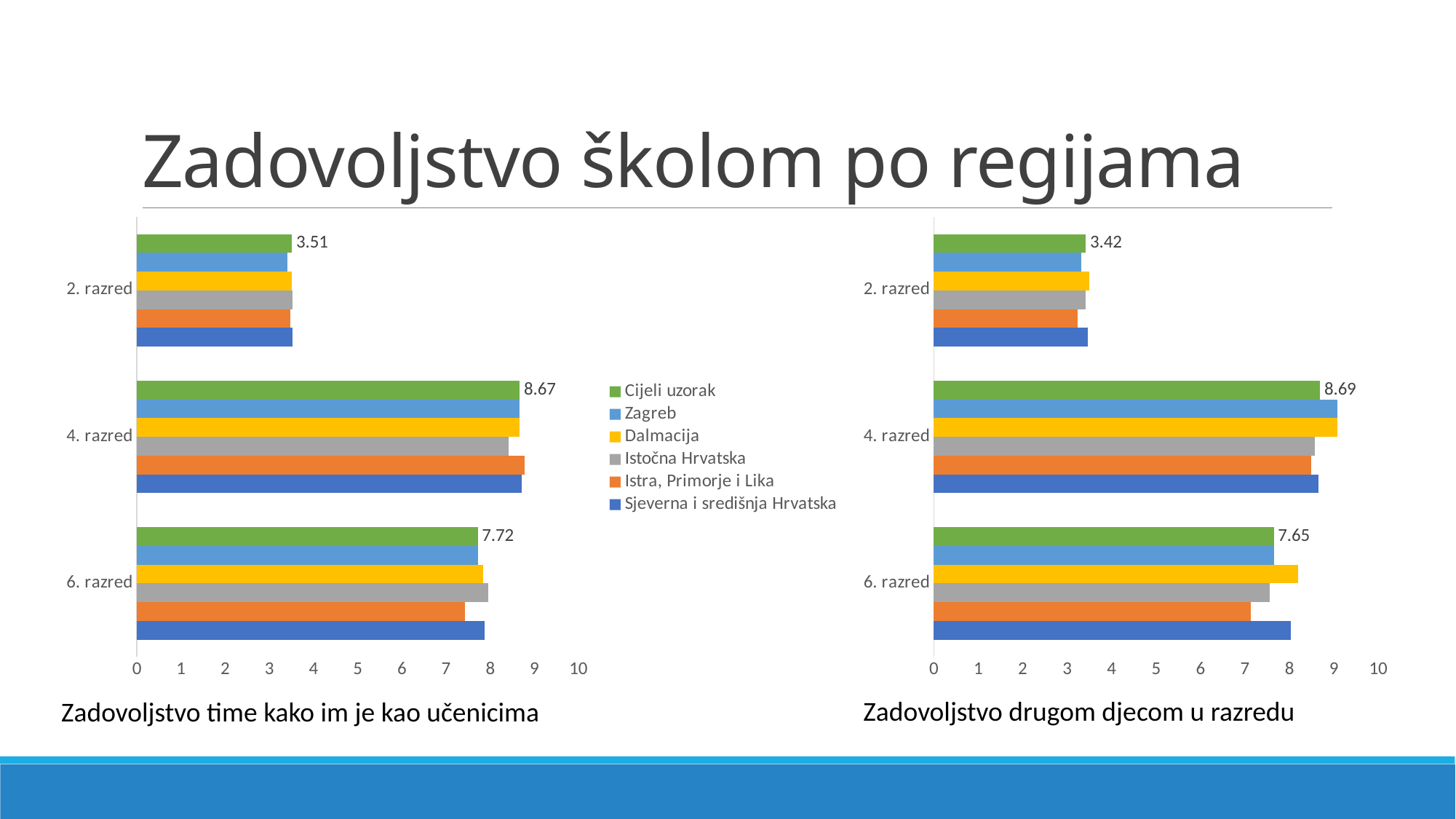
Which is larger: the Cijeli uzorak value for 4. razred in the left chart or in the right chart? Right chart (8.69) In the left chart (Zadovoljstvo time kako im je kao učenicima), what is the value for Cijeli uzorak in 6. razred? 7.72 In the right chart (Zadovoljstvo drugom djecom u razredu), is the value for Dalmacija in 6. razred greater or less than 8? greater What kind of chart is the left chart (Zadovoljstvo time kako im je kao učenicima)? Bar chart How many series does the legend list? 6 In the left chart (Zadovoljstvo time kako im je kao učenicima), is the value for Istra, Primorje i Lika in 6. razred greater or less than 8? less In the left chart (Zadovoljstvo time kako im je kao učenicima), what is the difference between the Cijeli uzorak values for 4. razred and 2. razred? 5.16 In the left chart (Zadovoljstvo time kako im je kao učenicima), which grade has the lowest Cijeli uzorak value? 2. razred In the left chart (Zadovoljstvo time kako im je kao učenicima), what is the value for Cijeli uzorak in 4. razred? 8.67 In the right chart (Zadovoljstvo drugom djecom u razredu), which grade has the highest Cijeli uzorak value? 4. razred In the right chart (Zadovoljstvo drugom djecom u razredu), what is the value for Cijeli uzorak in 2. razred? 3.42 In the right chart (Zadovoljstvo drugom djecom u razredu), what is the difference between the Cijeli uzorak values for 4. razred and 6. razred? 1.04